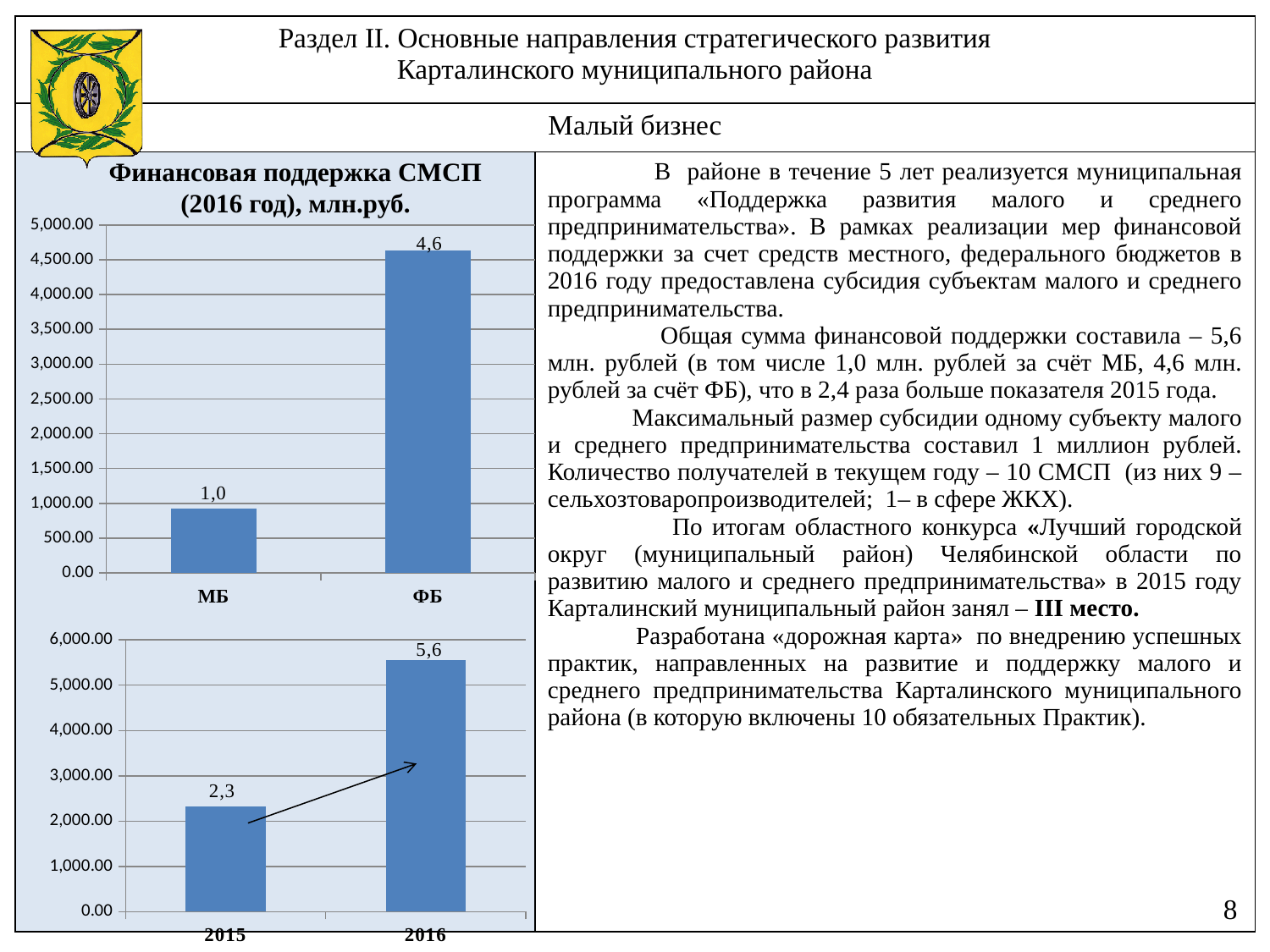
In the top chart 'Финансовая поддержка СМСП (2016 год), млн.руб.', how many categories are shown on the x axis? 2 In the bottom chart on the slide, what is the value labelled for 2016? 5,6 In the bottom chart on the slide, which year has the lower value? 2015 In the bottom chart on the slide, what is the difference between the labelled values for 2016 and 2015? 3,3 In the top chart 'Финансовая поддержка СМСП (2016 год), млн.руб.', what is the difference between the labelled values for ФБ and МБ? 3,6 In the top chart 'Финансовая поддержка СМСП (2016 год), млн.руб.', what is the value labelled for ФБ? 4,6 In the top chart 'Финансовая поддержка СМСП (2016 год), млн.руб.', which category has the higher value? ФБ What is the title of the top chart on the slide? Финансовая поддержка СМСП (2016 год), млн.руб. What type of chart is the top chart 'Финансовая поддержка СМСП (2016 год), млн.руб.'? bar chart In the top chart 'Финансовая поддержка СМСП (2016 год), млн.руб.', what is the value labelled for МБ? 1,0 In the bottom chart on the slide, do the values rise or fall from 2015 to 2016? rise In the bottom chart on the slide, what is the value labelled for 2015? 2,3